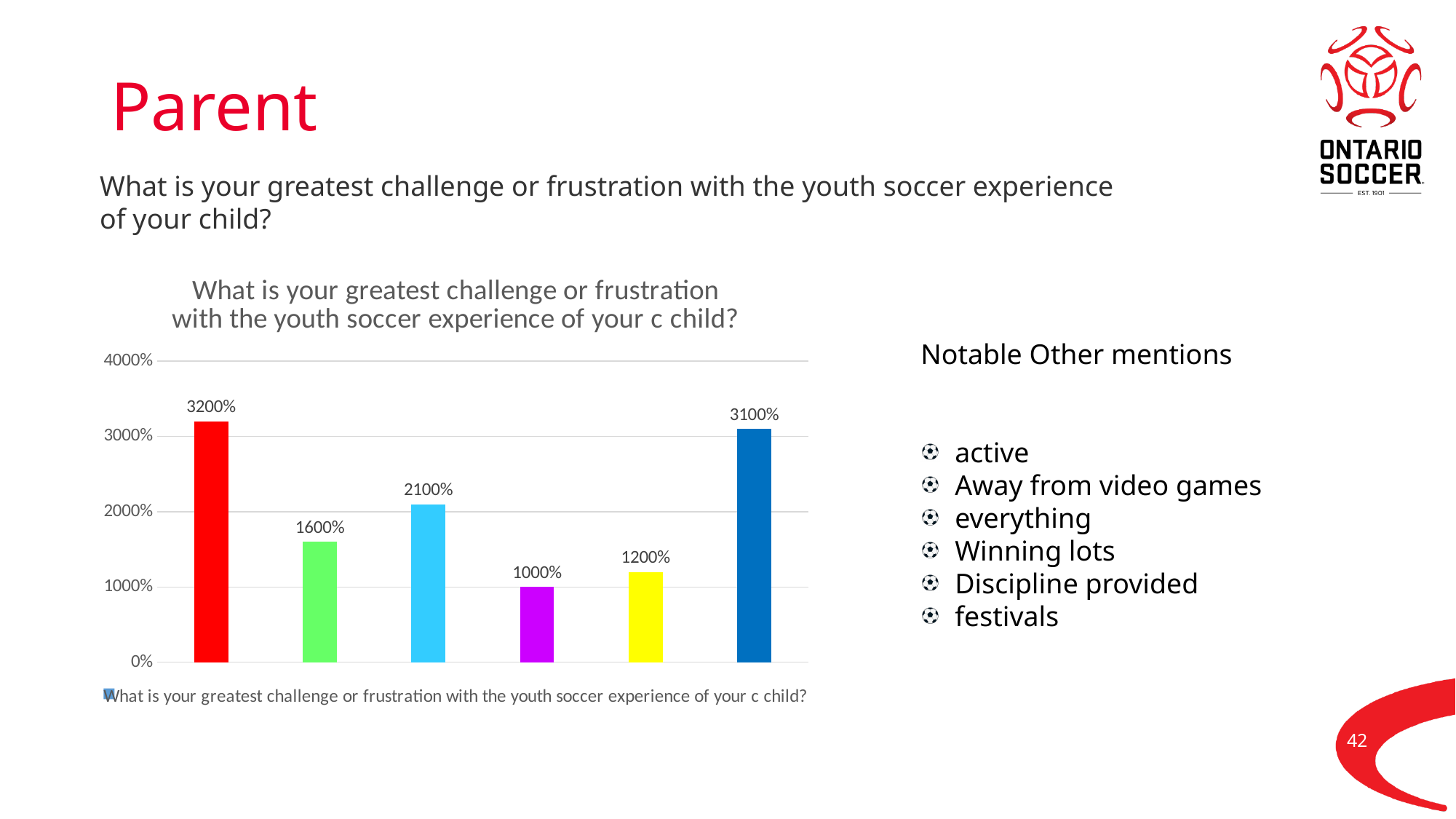
How many series does the chart legend list? 1 Which is larger, the cyan (third) bar or the yellow (fifth) bar? the cyan (third) bar What is the title of the chart? What is your greatest challenge or frustration with the youth soccer experience of your c child? What is the value of the magenta (fourth) bar in the chart? 1000% What is the value of the blue (last) bar in the chart? 3100% Which bar has the lowest value in the chart? the magenta (fourth) bar, 1000% What is the difference between the red (first) bar and the blue (last) bar? 100% How many bars are plotted in the chart? 6 What is the value of the green (second) bar in the chart? 1600% What is the value of the red (first) bar in the chart? 3200% What type of chart is shown on the slide? bar chart Which bar has the highest value in the chart? the red (first) bar, 3200%